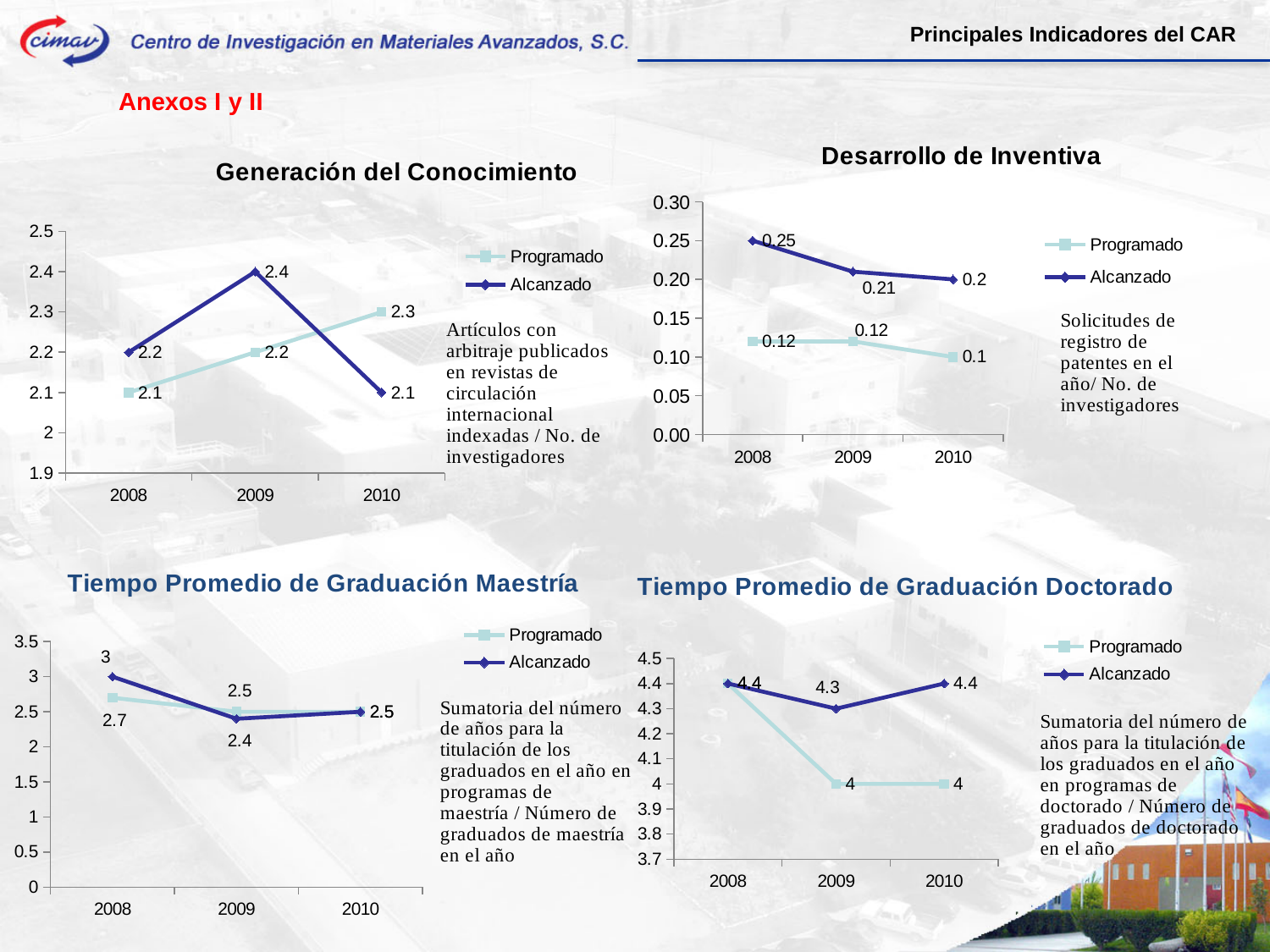
In the 'Generación del Conocimiento' chart, does the Programado series rise or fall from 2008 to 2010? rise In the 'Desarrollo de Inventiva' chart, which year has the highest Alcanzado value? 2008 What kind of chart is 'Tiempo Promedio de Graduación Doctorado'? line chart In the 'Tiempo Promedio de Graduación Maestría' chart, which is larger in 2009, Programado or Alcanzado? Programado In the 'Tiempo Promedio de Graduación Doctorado' chart, what is the Alcanzado value for 2009? 4.3 In the 'Generación del Conocimiento' chart, what is the Programado value for 2010? 2.3 In the 'Tiempo Promedio de Graduación Maestría' chart, what is the Alcanzado value for 2008? 3 In the 'Desarrollo de Inventiva' chart, how many series does the legend list? 2 In the 'Generación del Conocimiento' chart, what is the difference between the Alcanzado and Programado values in 2009? 0.2 In the 'Generación del Conocimiento' chart, what is the Alcanzado value for 2009? 2.4 In the 'Desarrollo de Inventiva' chart, what is the Programado value for 2010? 0.1 In the 'Desarrollo de Inventiva' chart, what is the Alcanzado value for 2008? 0.25